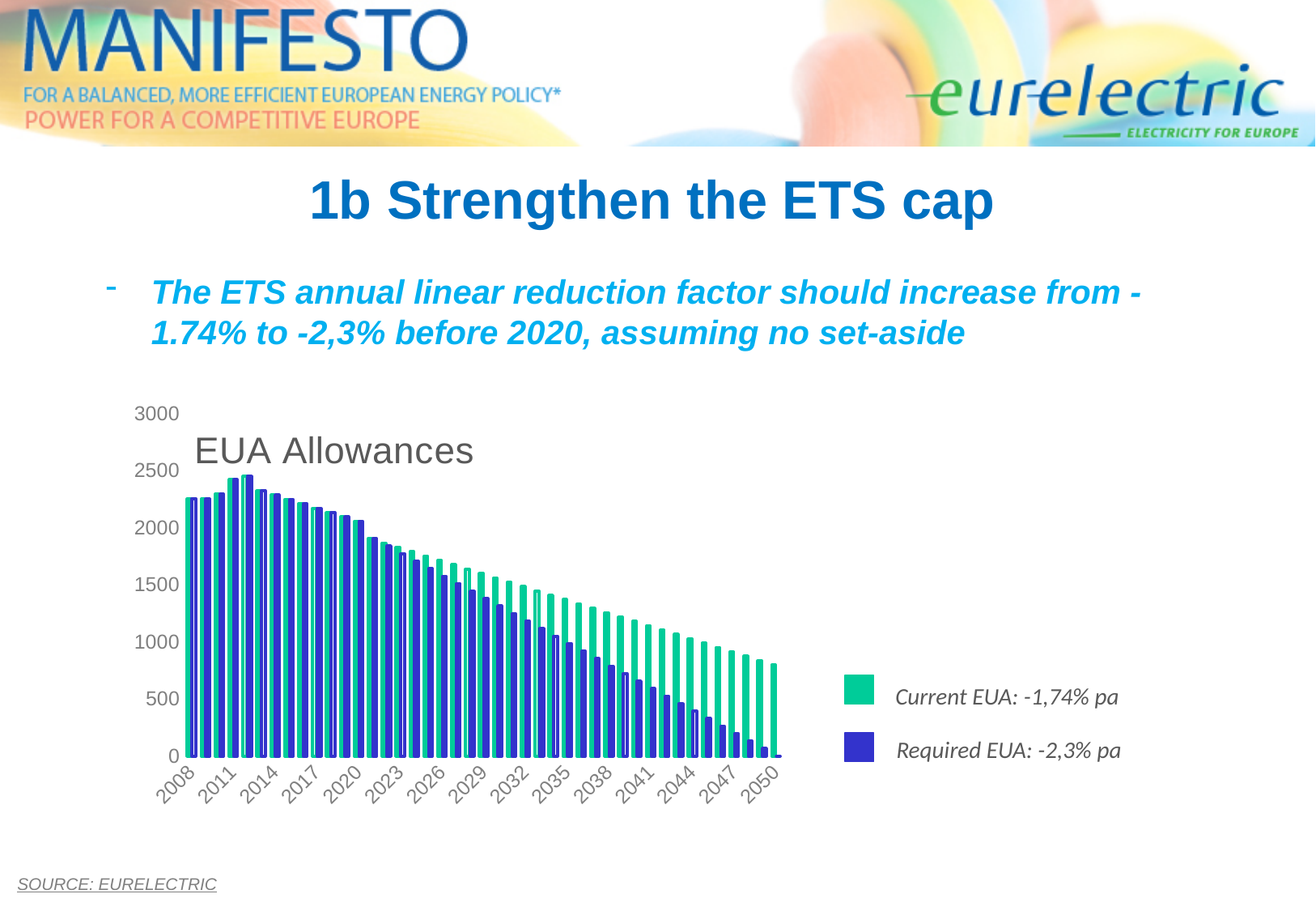
How many series does the legend of the EUA Allowances chart list? 2 What kind of chart is shown on the slide? bar chart Which series is shown in green in the EUA Allowances chart? Current EUA: -1,74% pa Which year has the lowest Required EUA value? 2050 Is the Required EUA value for 2038 greater or less than 1000? less Do the Required EUA values rise or fall from 2014 to 2050? fall Is the Required EUA value for 2047 greater or less than 500? less In 2044, which series has the larger value, Current EUA or Required EUA? Current EUA Is the Current EUA value for 2050 greater or less than 500? greater What is the title of the chart? EUA Allowances